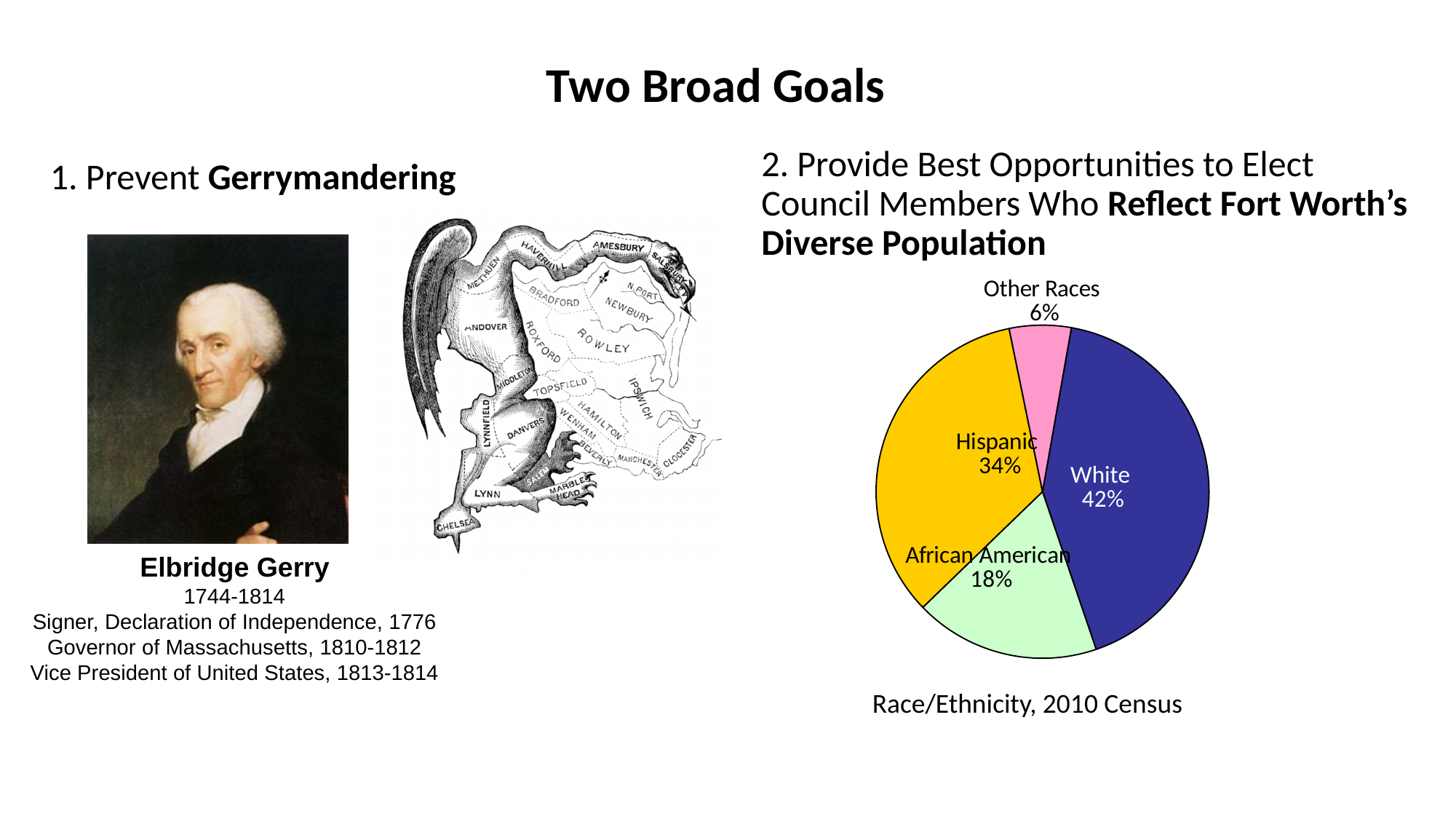
What kind of chart is shown on the slide? pie chart What share of the pie does Hispanic represent? 34% Which category has the largest slice of the pie? White What is the difference between the Hispanic and African American shares? 16% What share of the pie does Other Races represent? 6% What is the difference between the White and Hispanic shares? 8% What caption is shown below the pie chart? Race/Ethnicity, 2010 Census What share of the pie does White represent? 42% How many categories are shown in the pie chart? 4 Which is larger, the African American share or the Other Races share? African American Which category has the smallest slice of the pie? Other Races